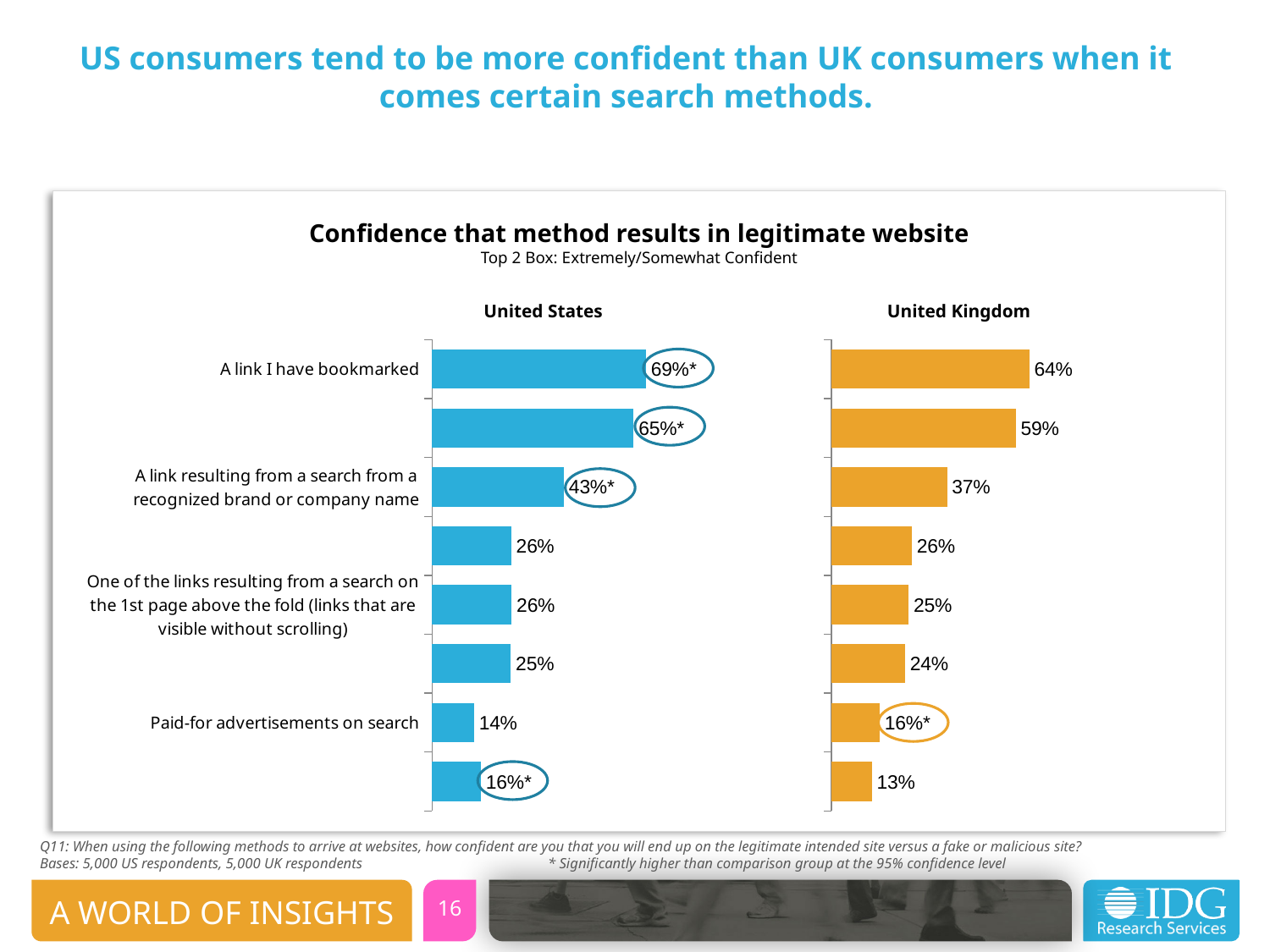
In the United Kingdom chart, what is the value for "A link resulting from a search from a recognized brand or company name"? 37% What type of chart is used for the United Kingdom data? Bar chart In the United States chart, what is the value for "A link I have bookmarked"? 69% For "Paid-for advertisements on search", which chart shows the larger value, United States or United Kingdom? United Kingdom In the United States chart, which category has the highest value? A link I have bookmarked In the United Kingdom chart, what is the value for "A link I have bookmarked"? 64% In the United States chart, which labeled category has the lowest value? Paid-for advertisements on search In the United States chart, what is the value for "A link resulting from a search from a recognized brand or company name"? 43% How many percentage points higher is the United States value for "A link I have bookmarked" than the United Kingdom value? 5 percentage points In the United States chart, what is the value for "Paid-for advertisements on search"? 14% How many bars are in the United States chart? 8 In the United Kingdom chart, what is the value for "Paid-for advertisements on search"? 16%